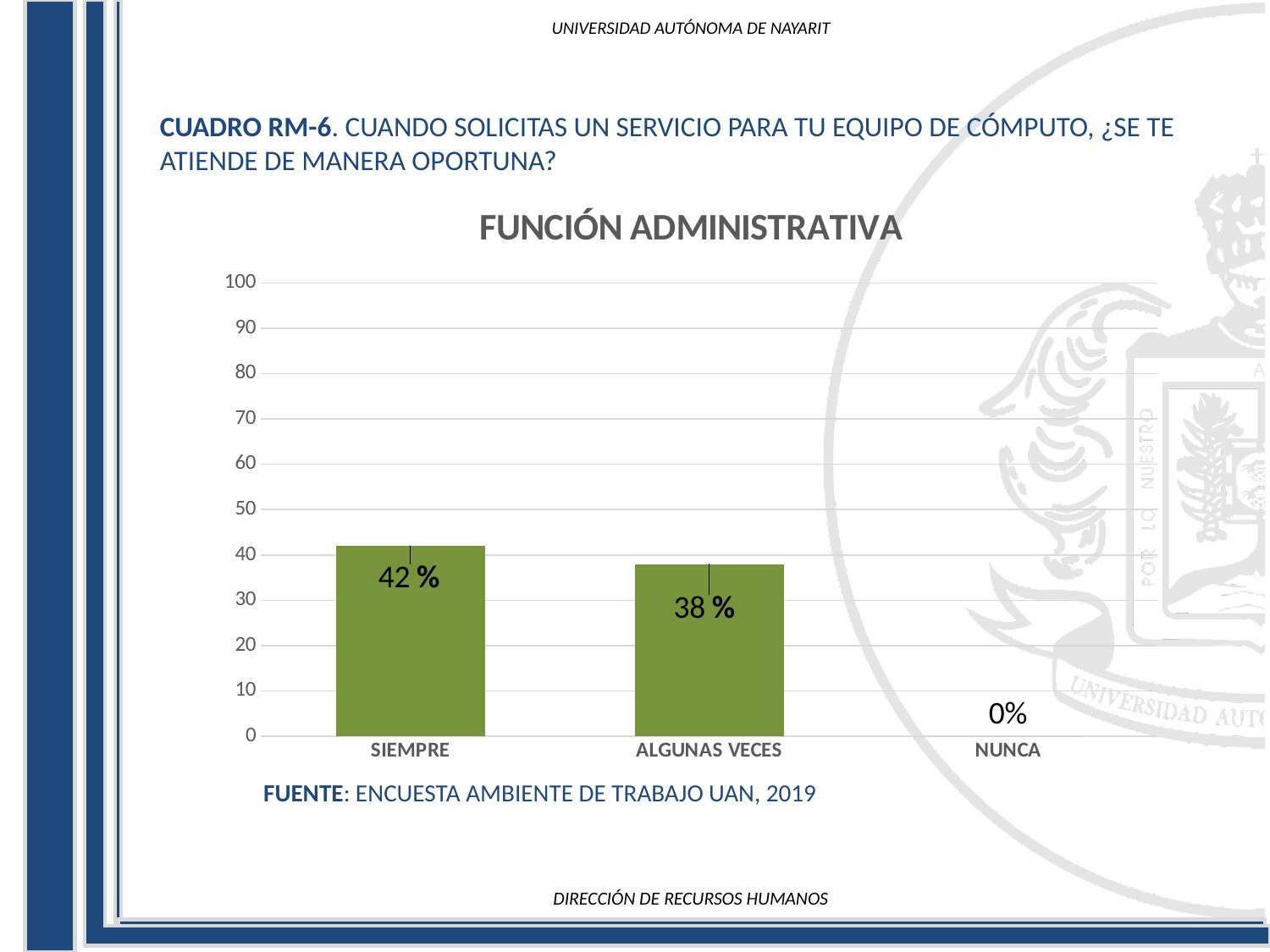
What is the value for SIEMPRE? 42 % What is the value for NUNCA? 0% Which category has the lowest value? NUNCA Which is larger, the value for SIEMPRE or the value for ALGUNAS VECES? SIEMPRE What kind of chart is shown? bar chart What is the difference between the values for SIEMPRE and ALGUNAS VECES? 4 Is the value for ALGUNAS VECES greater or less than 30? greater How many categories are shown on the x axis? 3 Is the value for SIEMPRE greater or less than 50? less What is the value for ALGUNAS VECES? 38 % What is the title of the chart? FUNCIÓN ADMINISTRATIVA Which category has the highest value? SIEMPRE